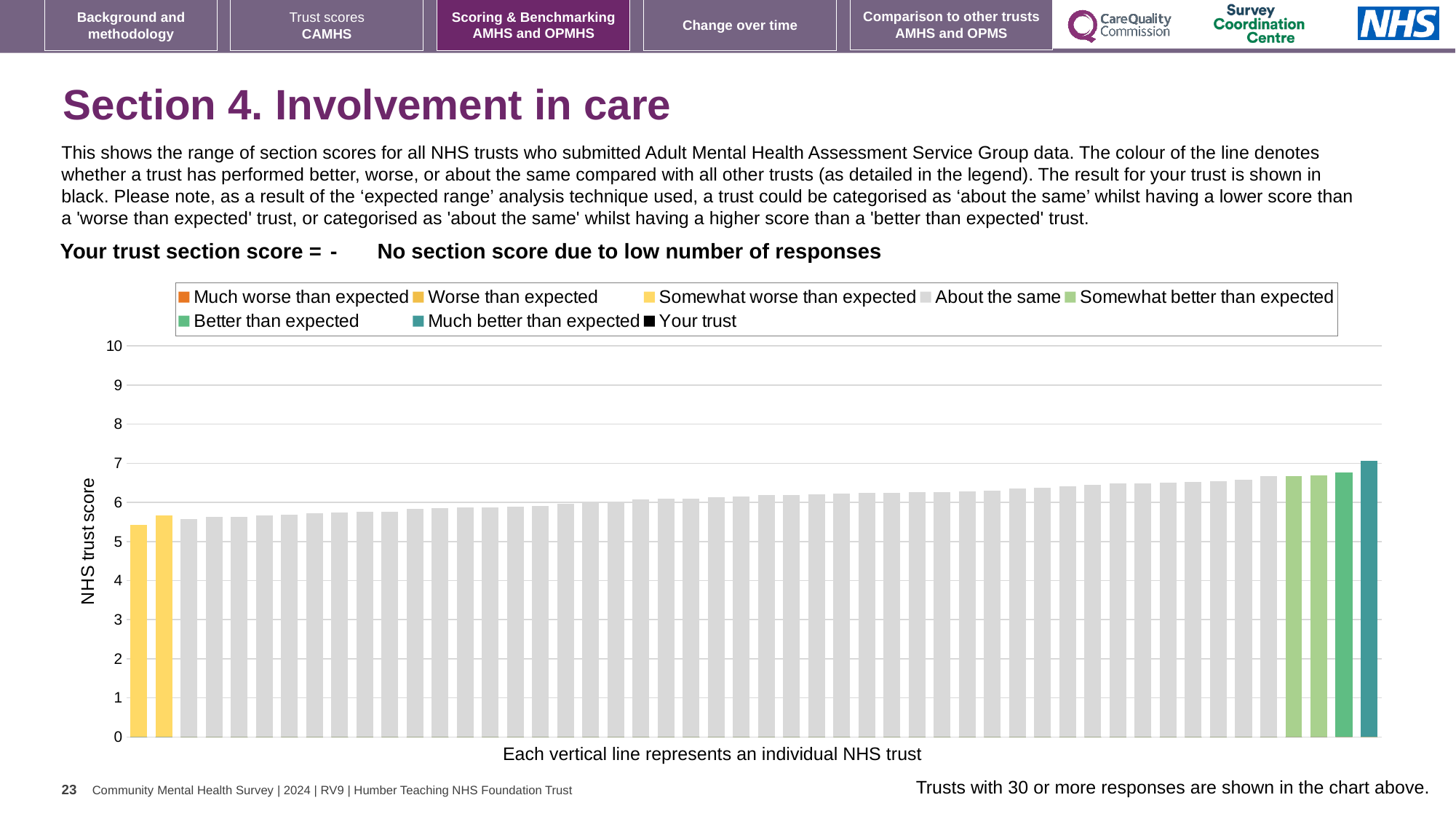
Is the value of the shortest bar greater or less than 6? less Is the value of the tallest bar greater or less than 6? greater Is the value of the shortest bar greater or less than 5? greater How many entries does the chart legend list? 8 What kind of chart is shown on the slide? bar chart How many bars in the chart are coloured yellow? 2 What is the label on the y axis of the chart? NHS trust score Do the bar values rise or fall from left to right along the x axis? rise Which legend category does the colour of the tallest bar correspond to? Much better than expected